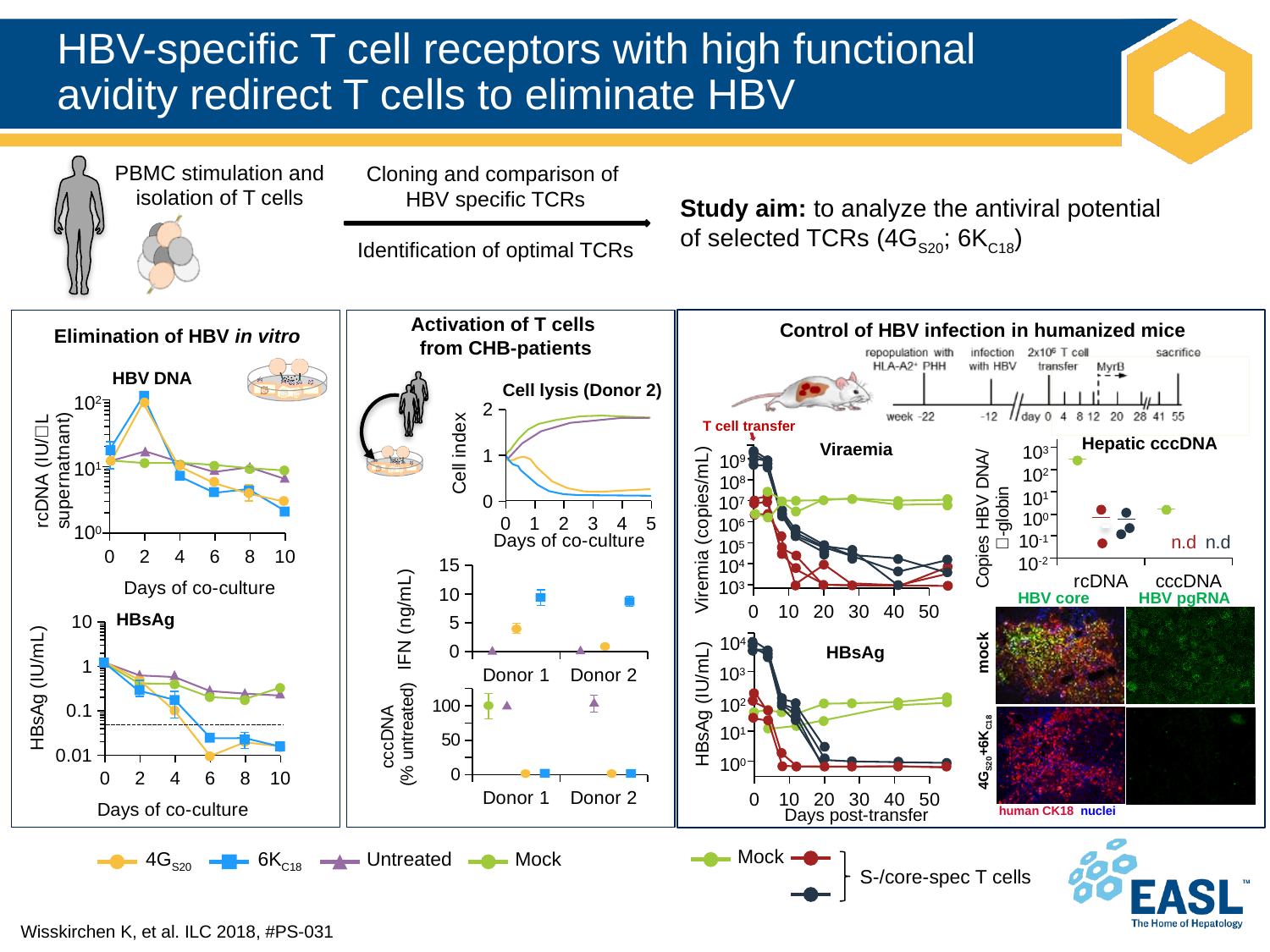
In the 'Viraemia' chart in the humanized mice panel, is the value for Mock at day 50 greater or less than 10^6? greater In the 'HBV DNA' chart in the 'Elimination of HBV in vitro' panel, what kind of chart is it? line chart In the IFN (ng/mL) chart, is the value for 6K_C18 in Donor 2 greater or less than 5? greater In the 'HBsAg' chart in the 'Elimination of HBV in vitro' panel, do the values for 6K_C18 rise or fall over the days of co-culture? fall How many series does the legend below the 'Elimination of HBV in vitro' panel list? 4 In the 'HBsAg' chart in the 'Elimination of HBV in vitro' panel, is the value for 6K_C18 at day 10 greater or less than 0.1? less In the 'Cell lysis (Donor 2)' chart, do the values for 6K_C18 rise or fall over the days of co-culture? fall What is the title of the right-hand panel containing the 'Viraemia' and 'HBsAg' charts? Control of HBV infection in humanized mice How many x-axis tick labels does the 'HBV DNA' chart in the 'Elimination of HBV in vitro' panel show? 6